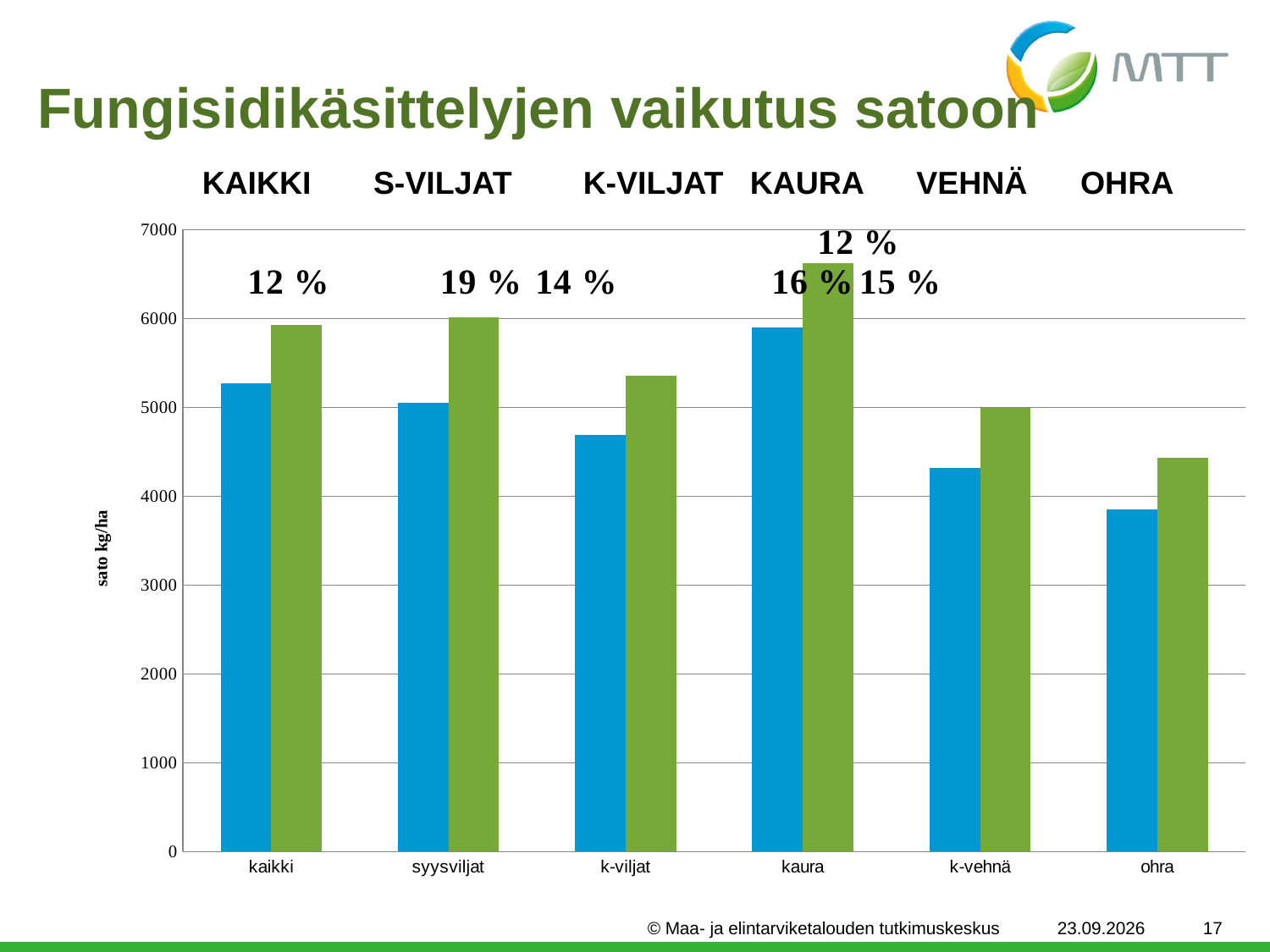
Is the value of the green bar for kaura greater or less than 6000? greater Which category has the shortest blue bar? ohra How many categories are shown on the x axis of the chart? 6 Is the value of the green bar for k-viljat greater or less than 5000? greater What is the label on the y axis of the chart? sato kg/ha Which category has the tallest green bar? kaura Which category has the shortest green bar? ohra Is the value of the blue bar for kaikki greater or less than 5000? greater How many bars are plotted for each category in the chart? 2 For the category kaura, which bar is taller, the blue one or the green one? the green one What kind of chart is shown on the slide? bar chart